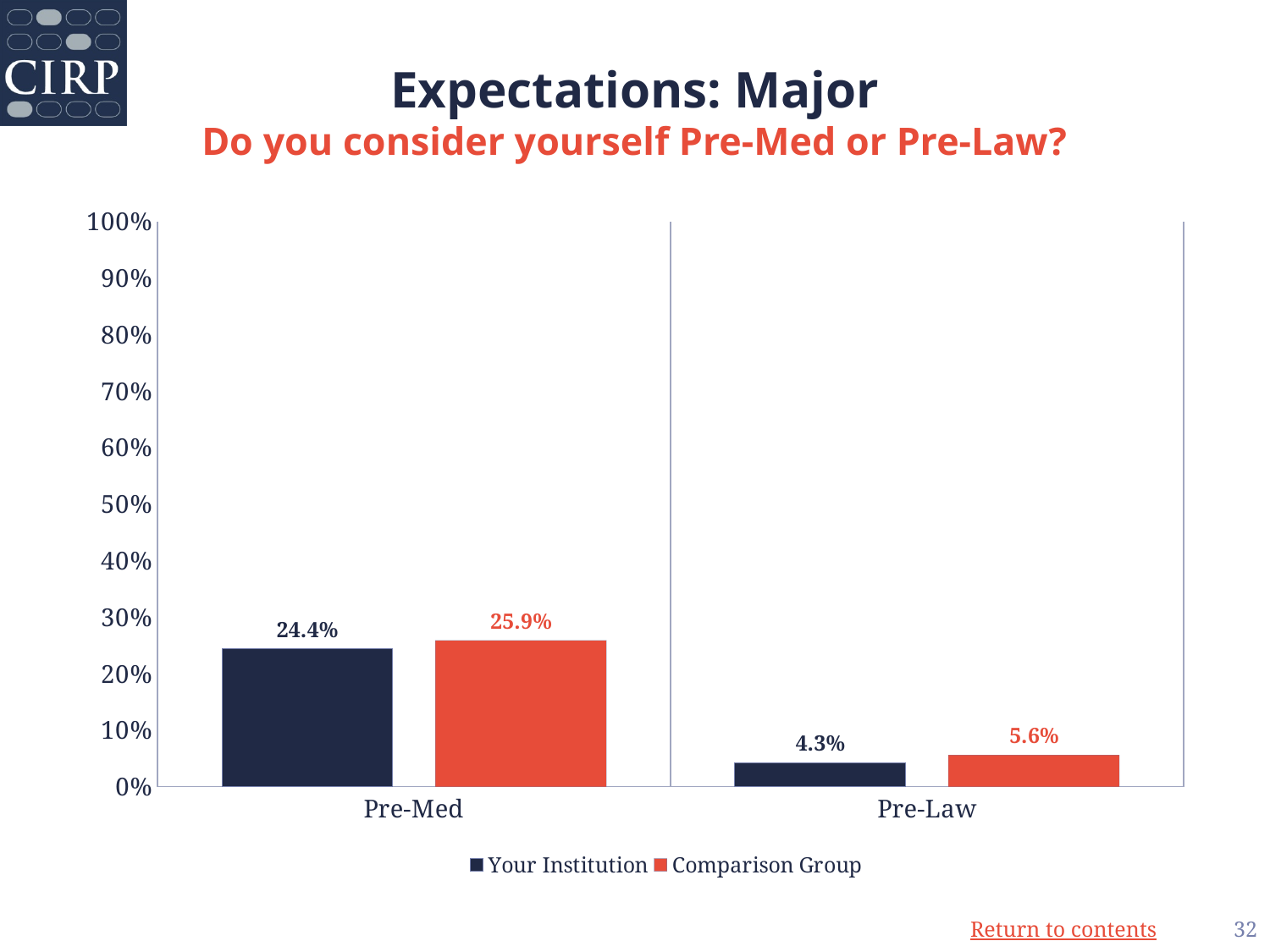
Which category has the highest value for Comparison Group? Pre-Med What is the value for Comparison Group for Pre-Law? 5.6% What is the value for Your Institution for Pre-Med? 24.4% What is the value for Your Institution for Pre-Law? 4.3% What kind of chart is shown on the slide? bar chart What is the value for Comparison Group for Pre-Med? 25.9% For Pre-Law, which is larger: Your Institution or Comparison Group? Comparison Group Is the value for Your Institution for Pre-Med greater or less than 30%? less Which category has the lowest value for Your Institution? Pre-Law How many series does the legend list? 2 How many categories are shown on the x axis? 2 What is the difference between the Comparison Group and Your Institution values for Pre-Med? 1.5%